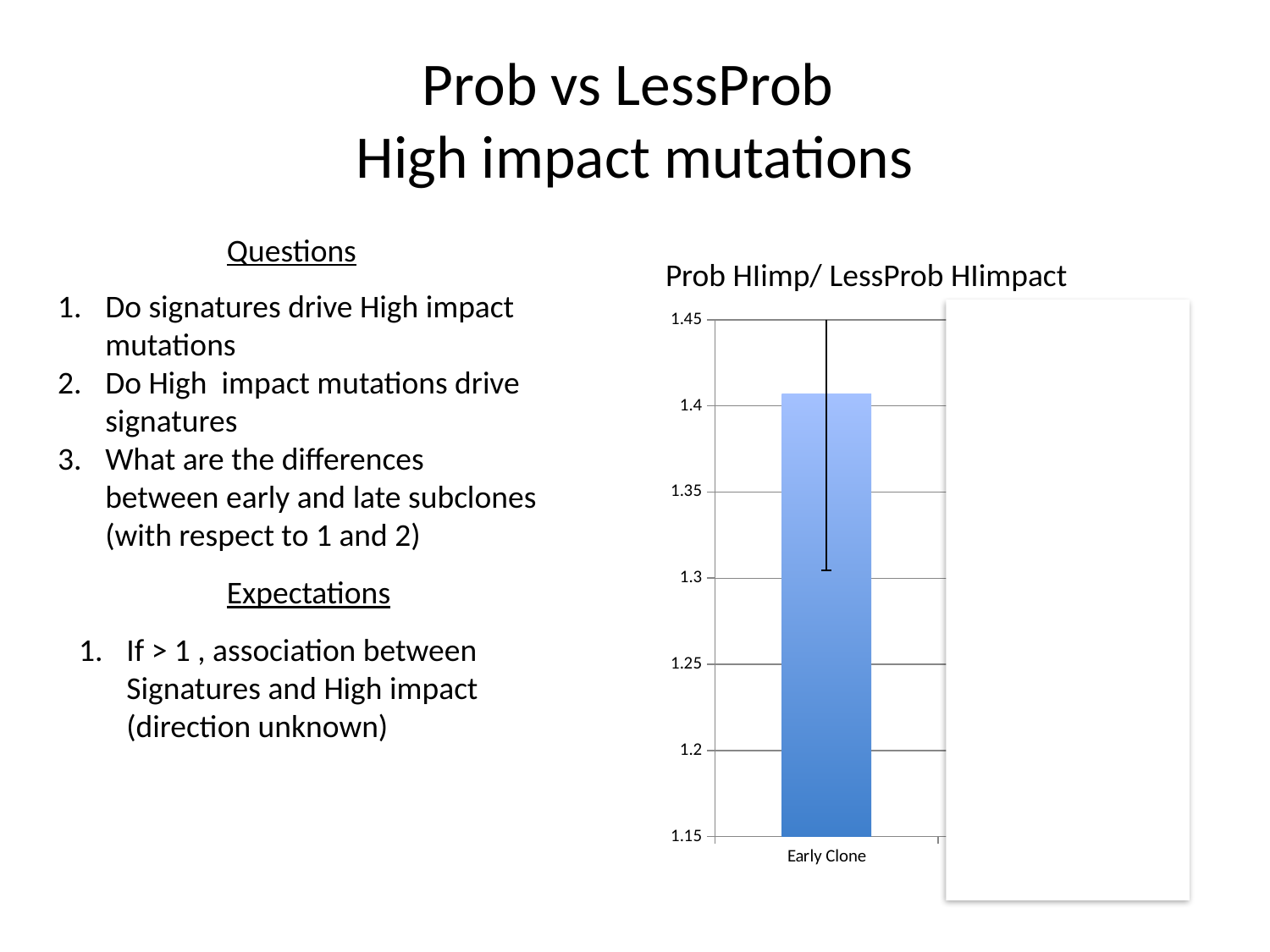
What is the title of the chart? Prob HIimp/ LessProb HIimpact Is the value for Early Clone greater or less than 1.45? less How many categories are labelled on the x axis of the chart? 1 What is the label of the category shown on the x axis of the chart? Early Clone What is the lowest value shown on the y axis of the chart? 1.15 What kind of chart is shown on the slide? bar chart Is the value for Early Clone greater or less than 1.35? greater Is the value for Early Clone greater or less than 1.2? greater